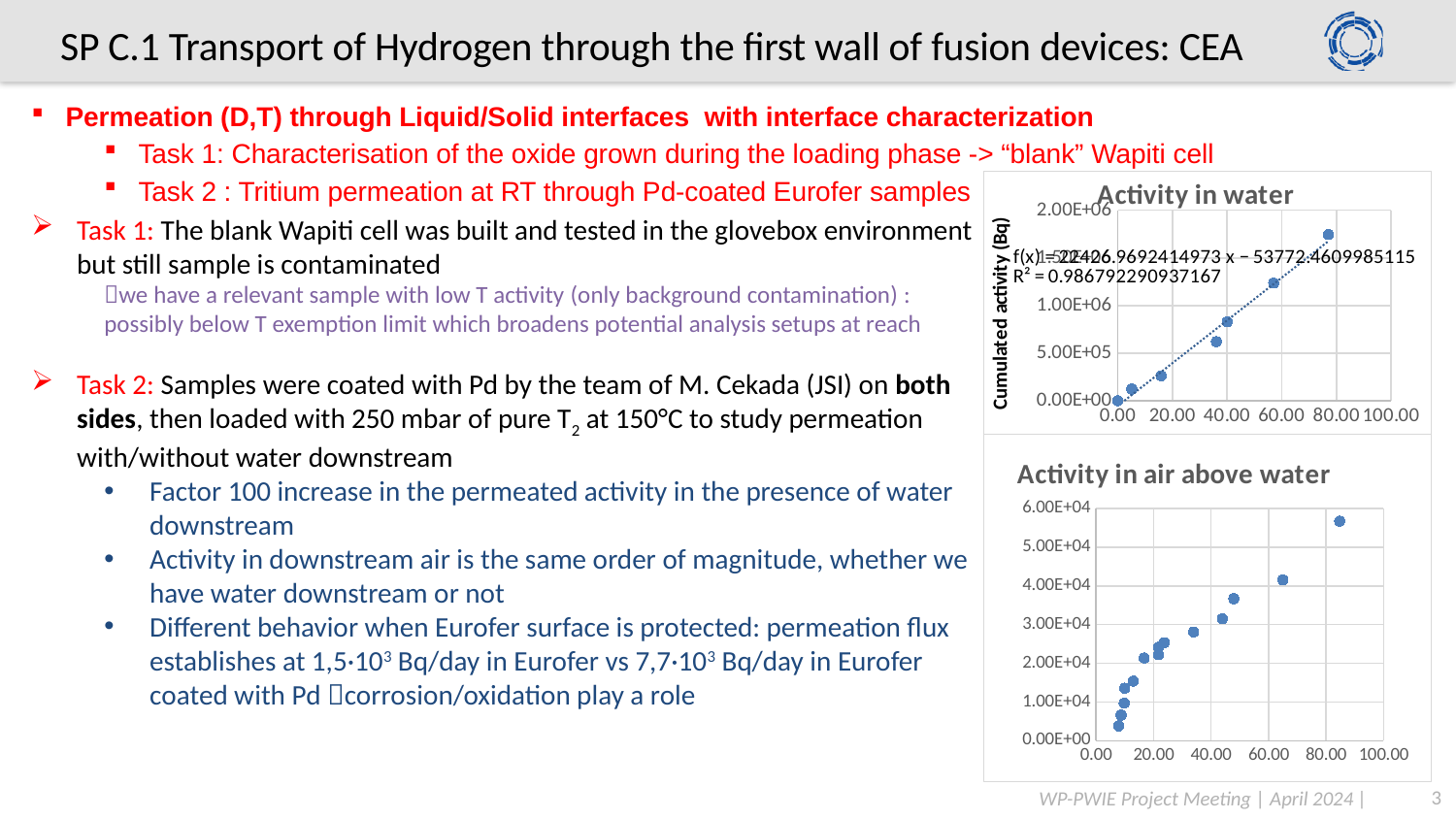
What kind of chart is the 'Activity in air above water' chart? scatter chart In the 'Activity in water' chart, do the plotted values rise or fall as the x value increases? rise What is the y-axis label of the 'Activity in water' chart? Cumulated activity (Bq) In the 'Activity in air above water' chart, is the value of the point near x = 45 greater or less than 4.00E+04? less In the 'Activity in water' chart, is the value of the point near x = 40 greater or less than 1.00E+06? less In the 'Activity in air above water' chart, are the points near x = 10 greater or less than 2.00E+04? less What kind of chart is the 'Activity in water' chart? scatter chart What R² value is printed on the 'Activity in water' chart? R² = 0.986792290937167 In the 'Activity in air above water' chart, do the plotted values rise or fall along the x axis? rise